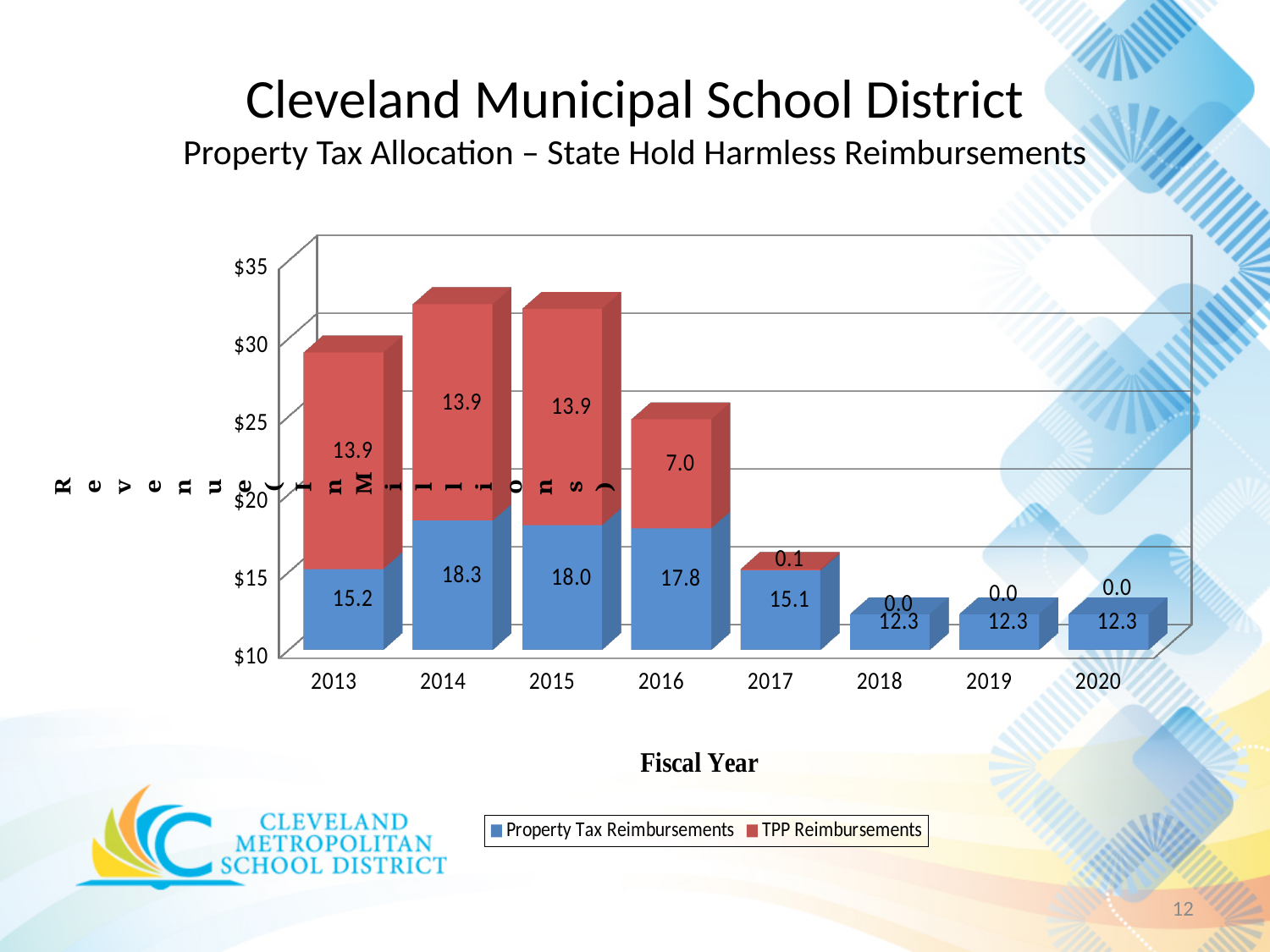
Which fiscal year has the highest Property Tax Reimbursements value? 2014 What is the value of TPP Reimbursements for fiscal year 2017? 0.1 What kind of chart is shown on the slide? Stacked bar chart What is the difference between the Property Tax Reimbursements values for 2014 and 2013? 3.1 How many fiscal years are shown on the x axis? 8 What is the value of TPP Reimbursements for fiscal year 2016? 7.0 What is the total of the stacked bar for fiscal year 2014? 32.2 How many series does the legend list? 2 Which fiscal year has the lowest Property Tax Reimbursements value among 2013 through 2017? 2017 What is the value of Property Tax Reimbursements for fiscal year 2014? 18.3 What is the total of the stacked bar for fiscal year 2016? 24.8 Which is larger, the TPP Reimbursements value for 2015 or for 2016? 2015